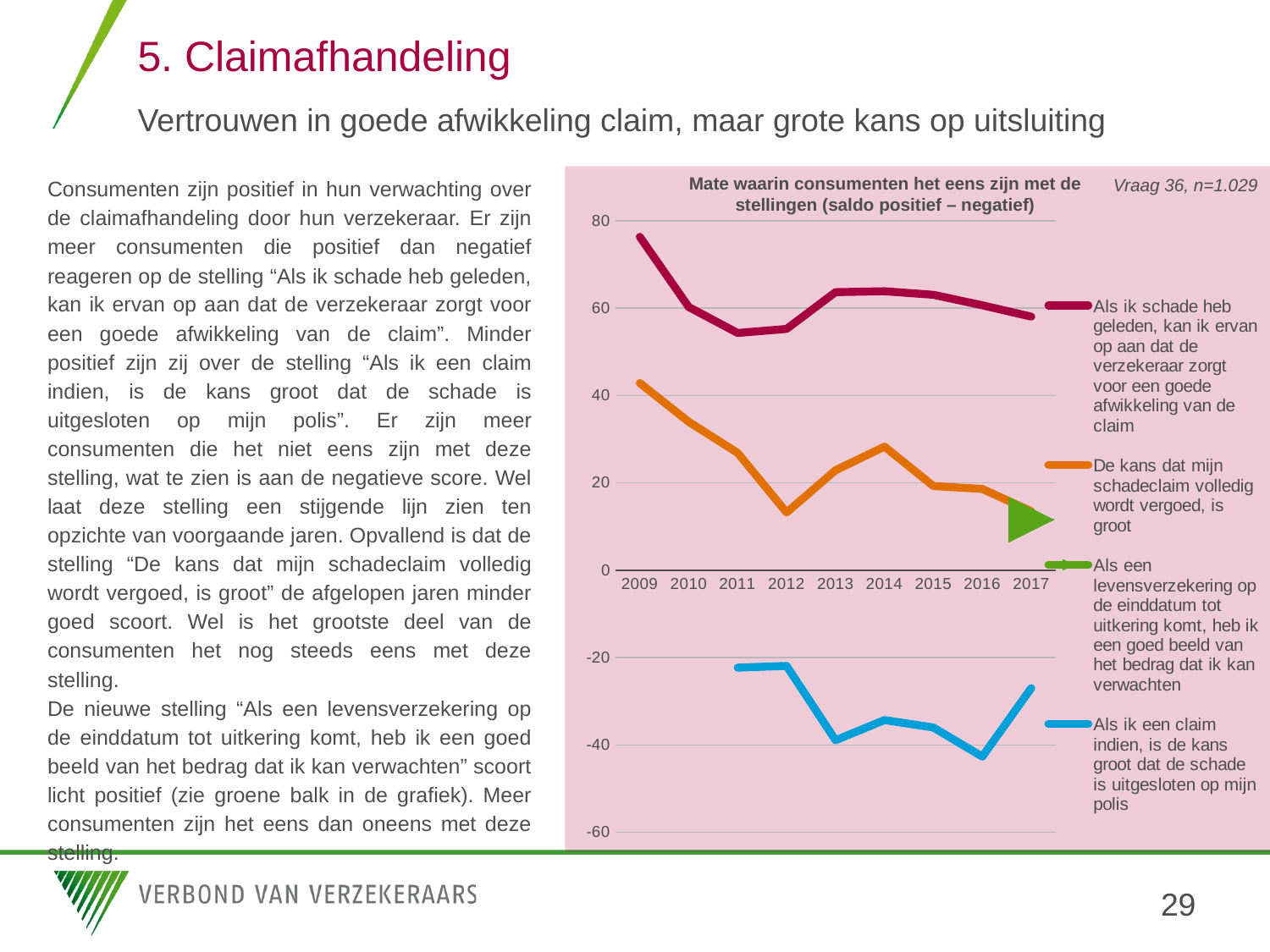
Is the 2009 value for 'Als ik schade heb geleden, kan ik ervan op aan dat de verzekeraar zorgt voor een goede afwikkeling van de claim' greater or less than 60? greater In which year is the line for 'Als ik een claim indien, is de kans groot dat de schade is uitgesloten op mijn polis' at its lowest? 2016 What kind of chart is shown on the slide? line chart How many series does the chart legend list? 4 Is the 2012 value for 'De kans dat mijn schadeclaim volledig wordt vergoed, is groot' greater or less than 20? less In 2009, which series has the higher value: 'Als ik schade heb geleden...' or 'De kans dat mijn schadeclaim volledig wordt vergoed, is groot'? Als ik schade heb geleden, kan ik ervan op aan dat de verzekeraar zorgt voor een goede afwikkeling van de claim How many years are shown on the x axis of the chart? 9 What is the title of the chart? Mate waarin consumenten het eens zijn met de stellingen (saldo positief – negatief) Is the 2016 value for 'Als ik een claim indien, is de kans groot dat de schade is uitgesloten op mijn polis' greater or less than -40? less Does the line for 'De kans dat mijn schadeclaim volledig wordt vergoed, is groot' overall rise or fall from 2009 to 2017? fall In which year is the line for 'Als ik schade heb geleden, kan ik ervan op aan dat de verzekeraar zorgt voor een goede afwikkeling van de claim' at its highest? 2009